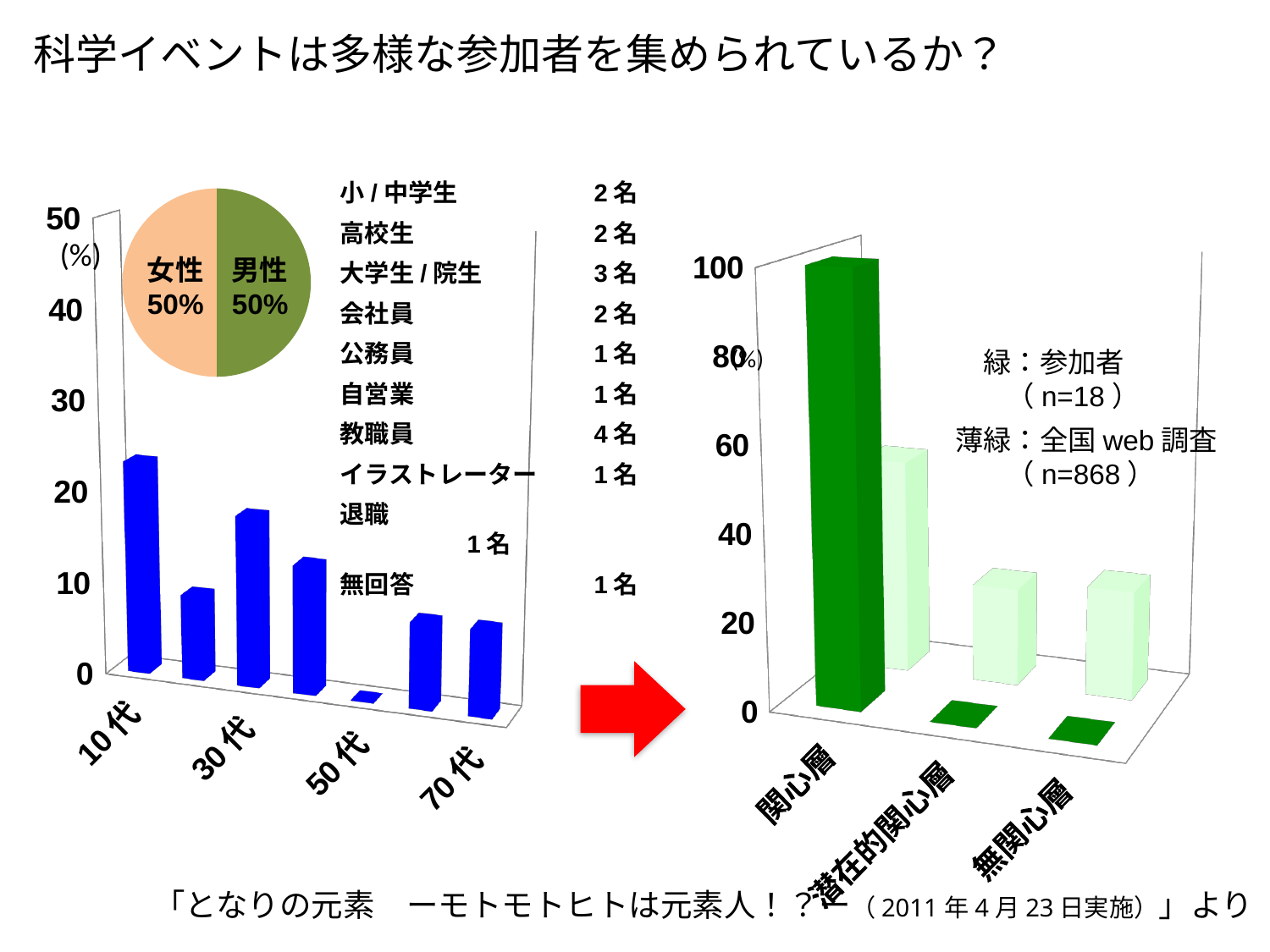
In the green bar chart on the right, for 関心層, which is larger: the 参加者 (dark green) bar or the 全国web調査 (light green) bar? 参加者 (dark green) In the pie chart, what share is labelled for 女性? 50% In the green bar chart on the right, is the 参加者 (dark green) value for 関心層 greater or less than 80? greater In the blue age-group bar chart on the left, which labelled age group has the lowest bar? 50代 What kind of chart is the blue chart on the left showing age groups? bar chart In the green bar chart on the right, how many series are described in the legend text? 2 What kind of chart shows the 女性 / 男性 split? pie chart In the green bar chart on the right, how many categories are on the x axis? 3 In the blue age-group bar chart on the left, how many bars are plotted? 7 In the blue age-group bar chart on the left, is the value for 10代 greater or less than 20? greater In the blue age-group bar chart on the left, which labelled age group has the highest bar? 10代